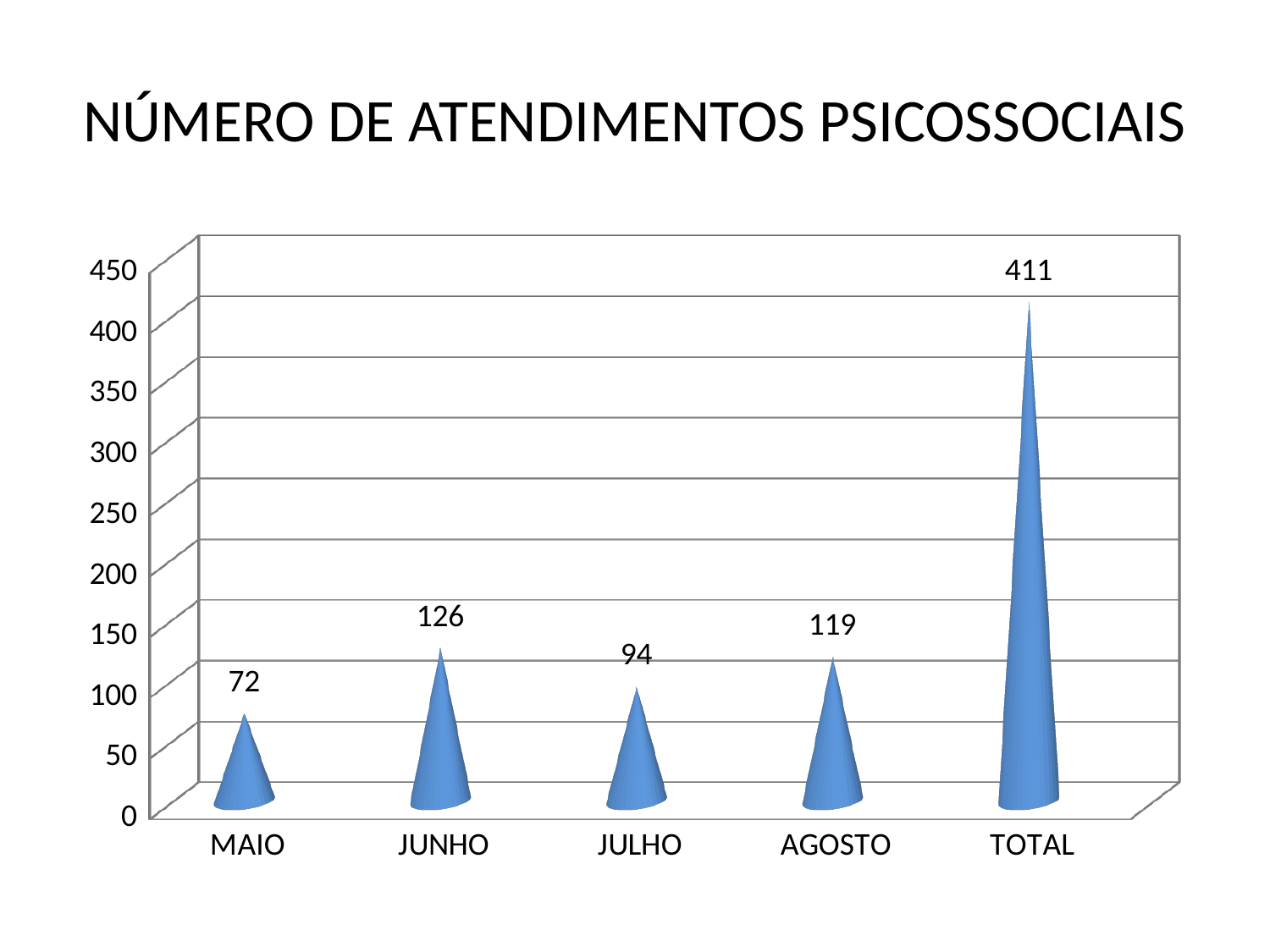
What is the title of the chart? NÚMERO DE ATENDIMENTOS PSICOSSOCIAIS What is the value for AGOSTO? 119 What is the value for MAIO? 72 What is the value for JULHO? 94 Which is larger, the value for JULHO or the value for AGOSTO? AGOSTO How many categories are shown on the x axis? 5 What kind of chart is shown on the slide? bar chart Which category has the lowest value? MAIO Which category has the highest value? TOTAL What is the difference between the values for JUNHO and MAIO? 54 What is the value for JUNHO? 126 What is the value for TOTAL? 411